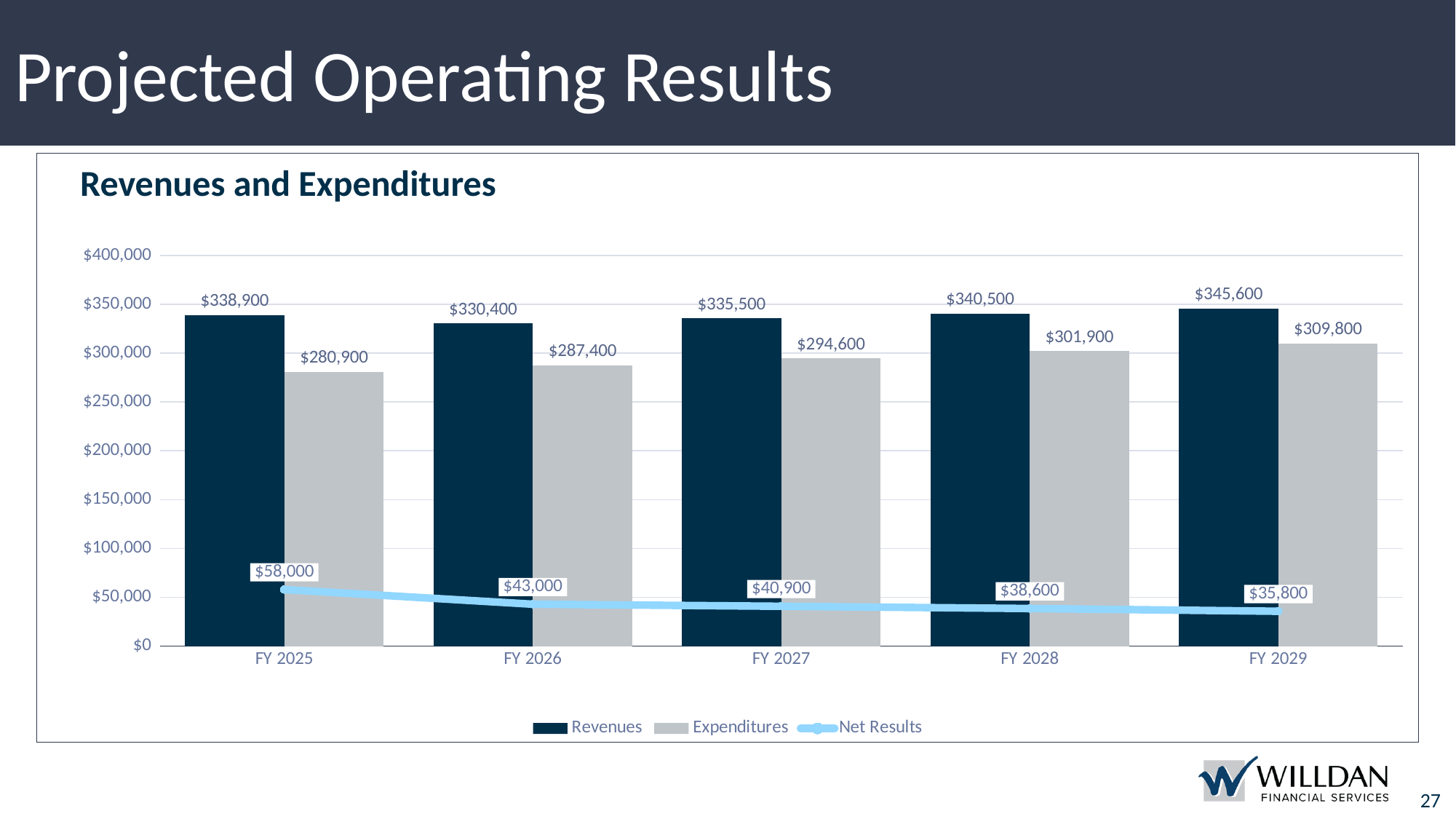
How many series does the legend list? 3 Is the Expenditures value for FY 2028 greater or less than $300,000? greater Which fiscal year has the highest Revenues? FY 2029 What is the Expenditures value for FY 2025? $280,900 Which is larger, Expenditures in FY 2029 or Revenues in FY 2025? Revenues in FY 2025 Which fiscal year has the lowest Net Results? FY 2029 Do the Expenditures values rise or fall from FY 2025 to FY 2029? rise What is the difference between Revenues and Expenditures in FY 2026? $43,000 How many fiscal years are shown on the x axis? 5 What is the title of the chart? Revenues and Expenditures What is the Revenues value for FY 2027? $335,500 What is the Net Results value for FY 2028? $38,600